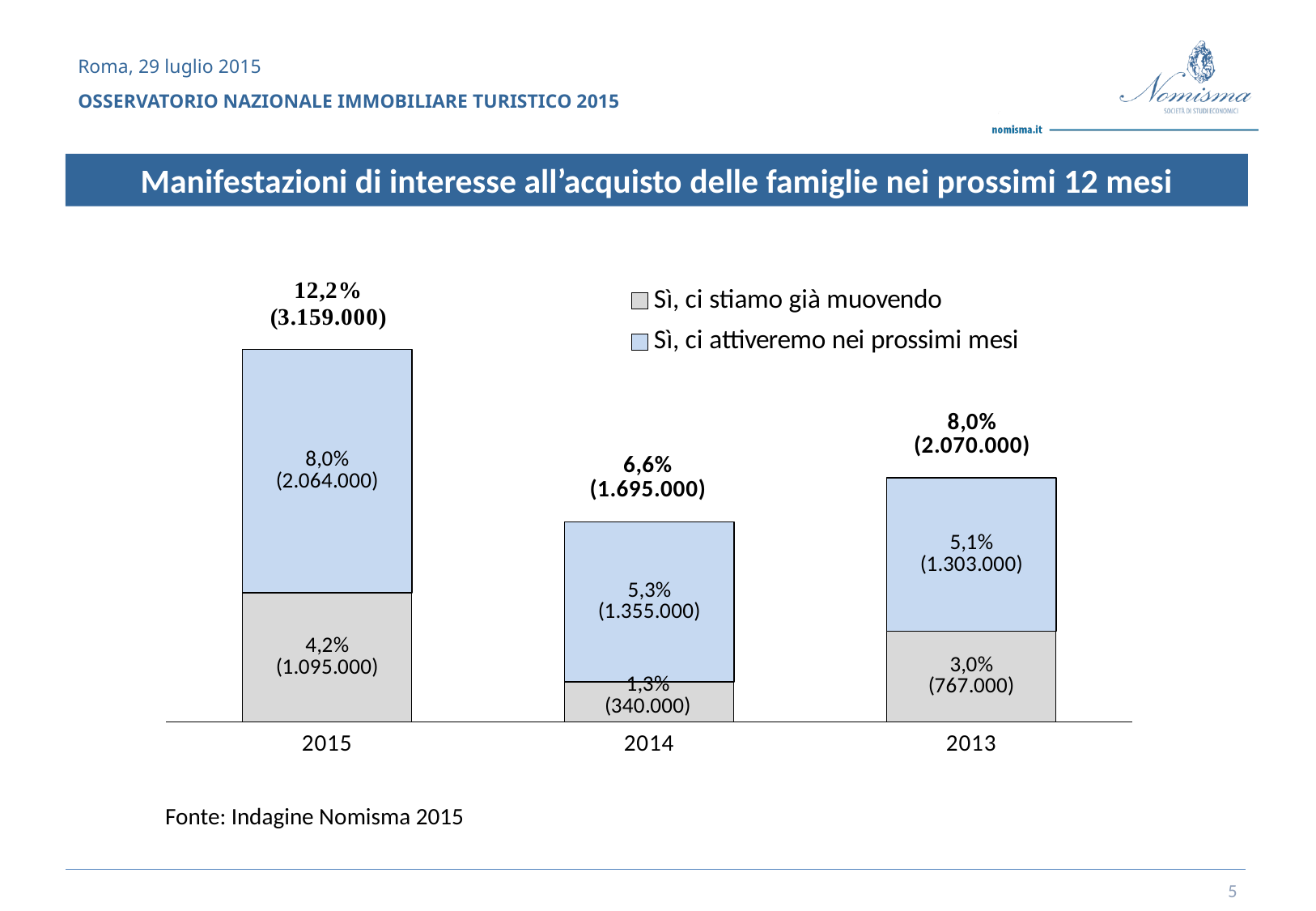
What is the total number of families shown above the 2014 bar? 1.695.000 How many series does the legend list? 2 Which is larger: the "Sì, ci stiamo già muovendo" value in 2015 or in 2013? 2015 What is the percentage for "Sì, ci attiveremo nei prossimi mesi" in 2014? 5,3% What kind of chart is shown on the slide? Stacked bar chart How many families does the "Sì, ci stiamo già muovendo" segment represent in 2013? 767.000 What is the total percentage shown above the 2015 bar? 12,2% What is the difference in percentage points between the "Sì, ci attiveremo nei prossimi mesi" values for 2015 and 2013? 2,9 Which year has the lowest value for "Sì, ci stiamo già muovendo"? 2014 What is the percentage for "Sì, ci stiamo già muovendo" in 2015? 4,2% Which year has the highest total percentage? 2015 How many years are shown on the x axis? 3